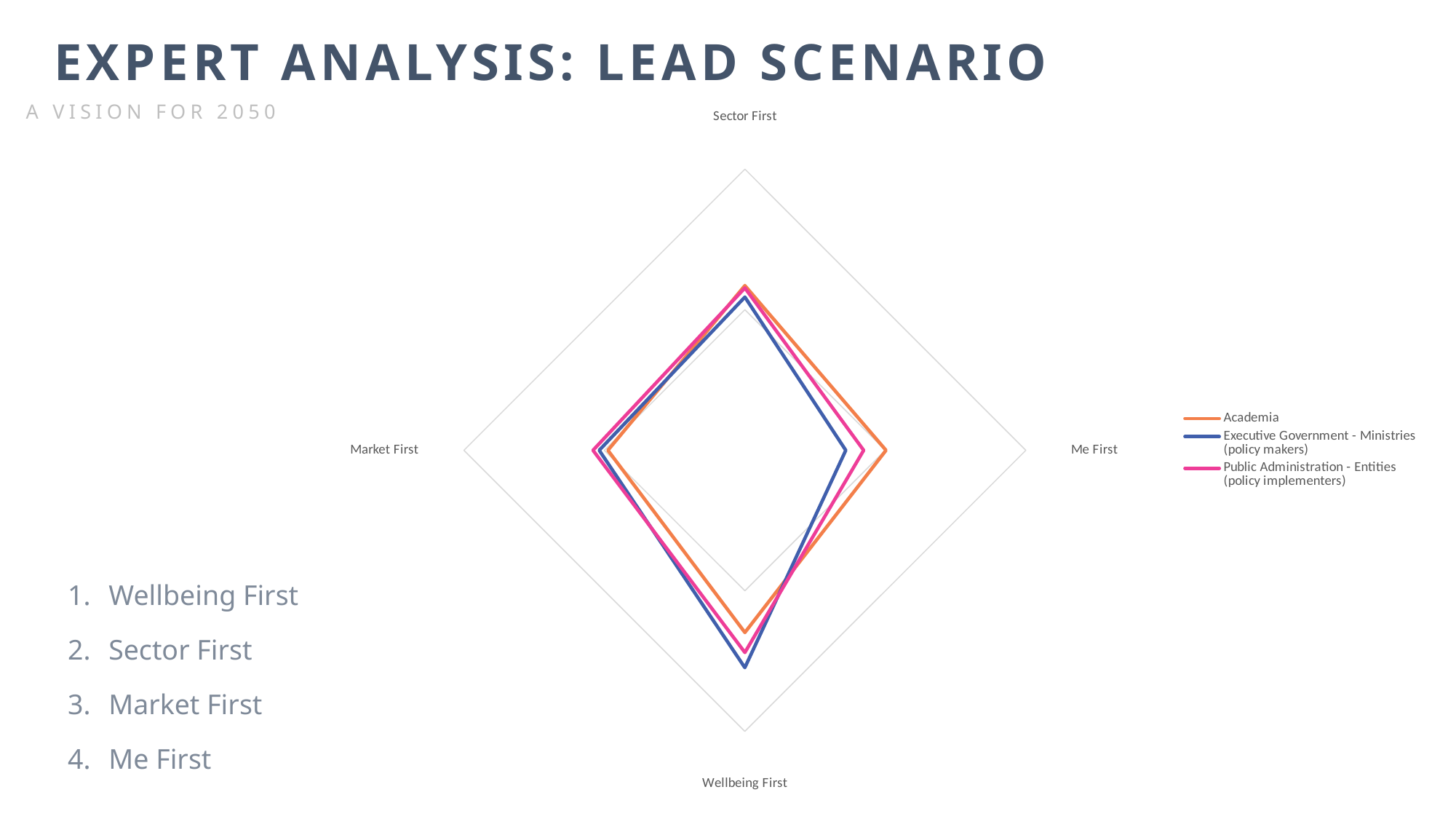
Which series is drawn in orange? Academia For the Wellbeing First category, which series has the lowest value? Academia For the Me First category, which series has the lowest value? Executive Government - Ministries (policy makers) For the Executive Government - Ministries (policy makers) series, which category has the highest value? Wellbeing First What kind of chart is shown on the slide? Radar chart For the Me First category, which series has the highest value? Academia Which category is at the top of the radar chart? Sector First For the Public Administration - Entities (policy implementers) series, which category has the lowest value? Me First For the Wellbeing First category, which series has the highest value? Executive Government - Ministries (policy makers) On the Sector First axis, which is larger: the Academia value or the Executive Government - Ministries (policy makers) value? Academia How many categories (axes) does the radar chart have? 4 How many series does the legend list? 3